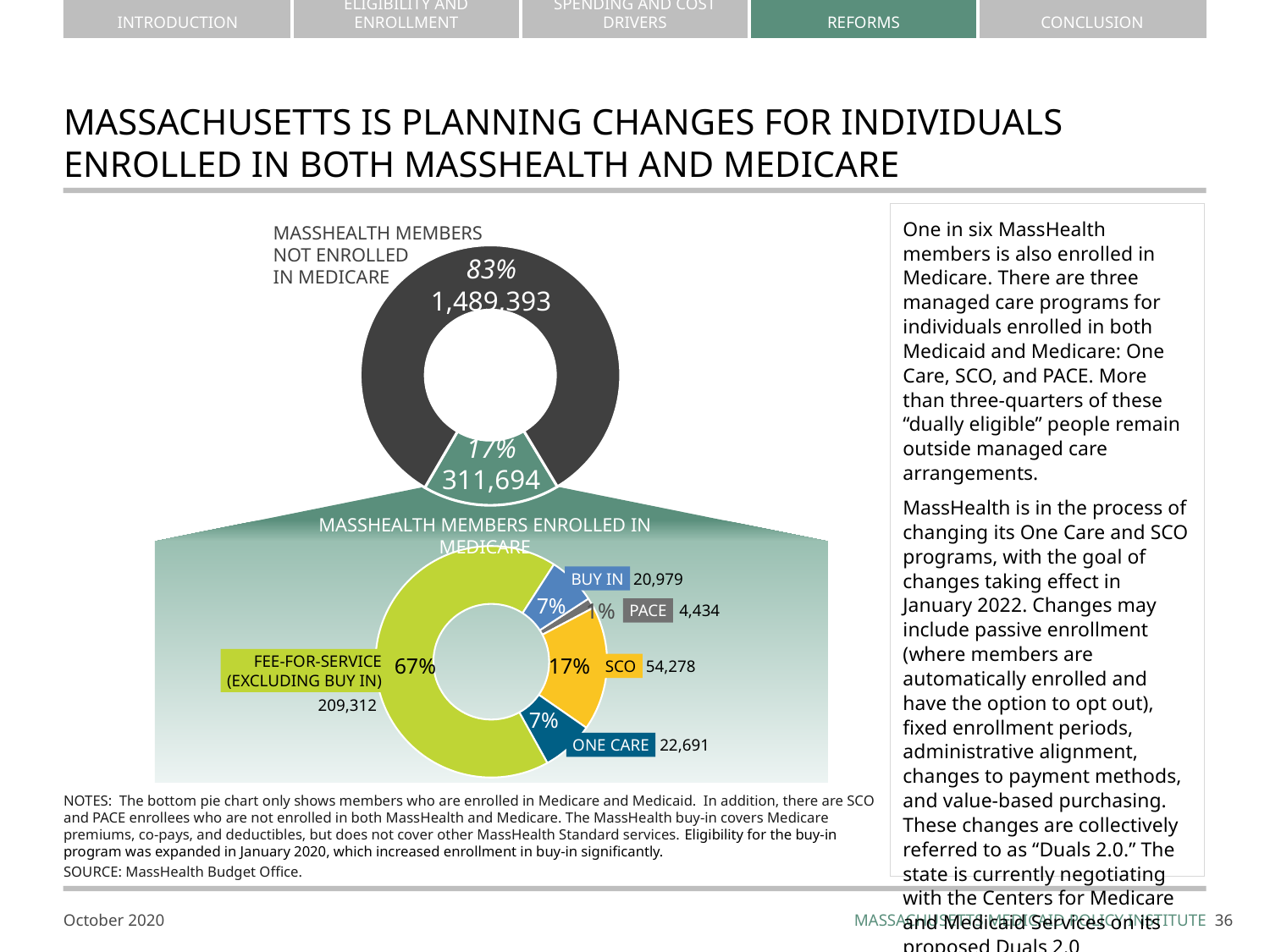
In the bottom chart, what share of members enrolled in Medicare are in fee-for-service (excluding buy in)? 67% In the top chart, what percentage of MassHealth members are enrolled in Medicare? 17% In the bottom chart, which category has the smallest value? PACE In the top chart, what is the number of MassHealth members not enrolled in Medicare? 1,489,393 In the bottom chart, which category has the largest value? Fee-for-service (excluding buy in) In the bottom chart, what is the difference between the SCO value and the One Care value? 31,587 What kind of chart is the top chart? Pie (donut) chart In the bottom chart, what is the value for SCO? 54,278 In the bottom chart, which is larger, One Care or Buy In? One Care In the bottom chart, what is the value for PACE? 4,434 How many categories does the bottom chart show? 5 In the top chart, how many MassHealth members are enrolled in Medicare? 311,694